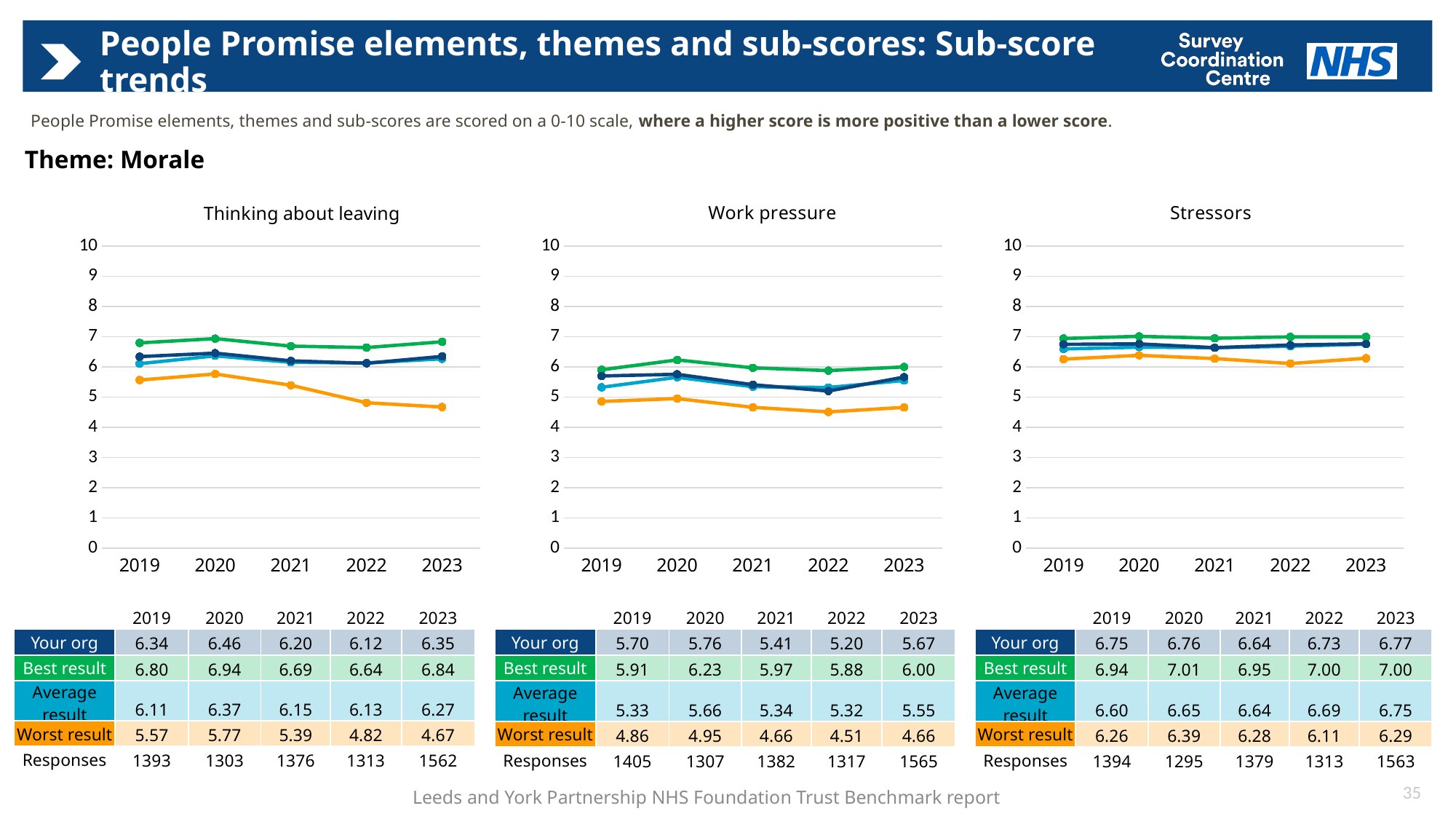
In the Thinking about leaving chart, what is the Your org score for 2023? 6.35 In the Work pressure chart, which year has the highest Your org score? 2020 In the Work pressure chart, is the Worst result value for 2022 greater or less than 5? less In the Thinking about leaving chart, which year has the lowest Worst result score? 2023 In the Work pressure chart, which is larger in 2019: the Your org score or the Average result score? Your org How many series are shown in the Thinking about leaving chart? 4 In the Work pressure chart, what is the Worst result score for 2022? 4.51 In the Thinking about leaving chart, does the Worst result line rise or fall from 2020 to 2023? Fall In the Stressors chart, what is the Best result score for 2020? 7.01 What type of chart is used for the Stressors sub-score? Line chart How many years are plotted on the x axis of the Work pressure chart? 5 In the Thinking about leaving chart, what is the difference between the Best result and Worst result scores in 2023? 2.17